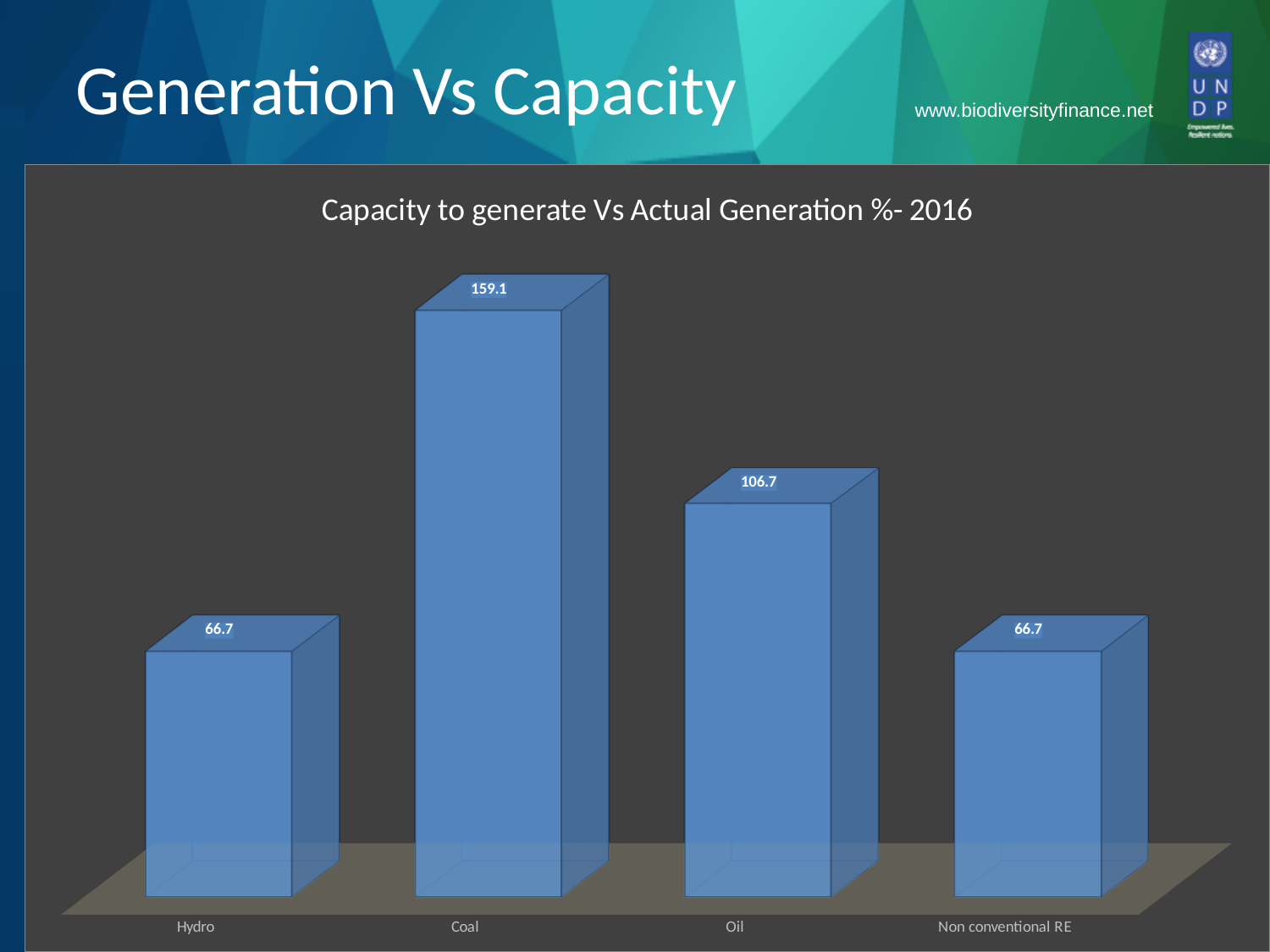
What is the difference between the values for Coal and Oil? 52.4 What is the value for Non conventional RE? 66.7 What is the value for Coal? 159.1 Which category has the highest value? Coal What is the title of the chart? Capacity to generate Vs Actual Generation %- 2016 How many categories are shown in the chart? 4 Which is larger, the value for Oil or the value for Non conventional RE? Oil Which is larger, the value for Coal or the value for Oil? Coal What kind of chart is shown on the slide? Bar chart What is the value for Oil? 106.7 What is the difference between the values for Oil and Hydro? 40 What is the value for Hydro? 66.7